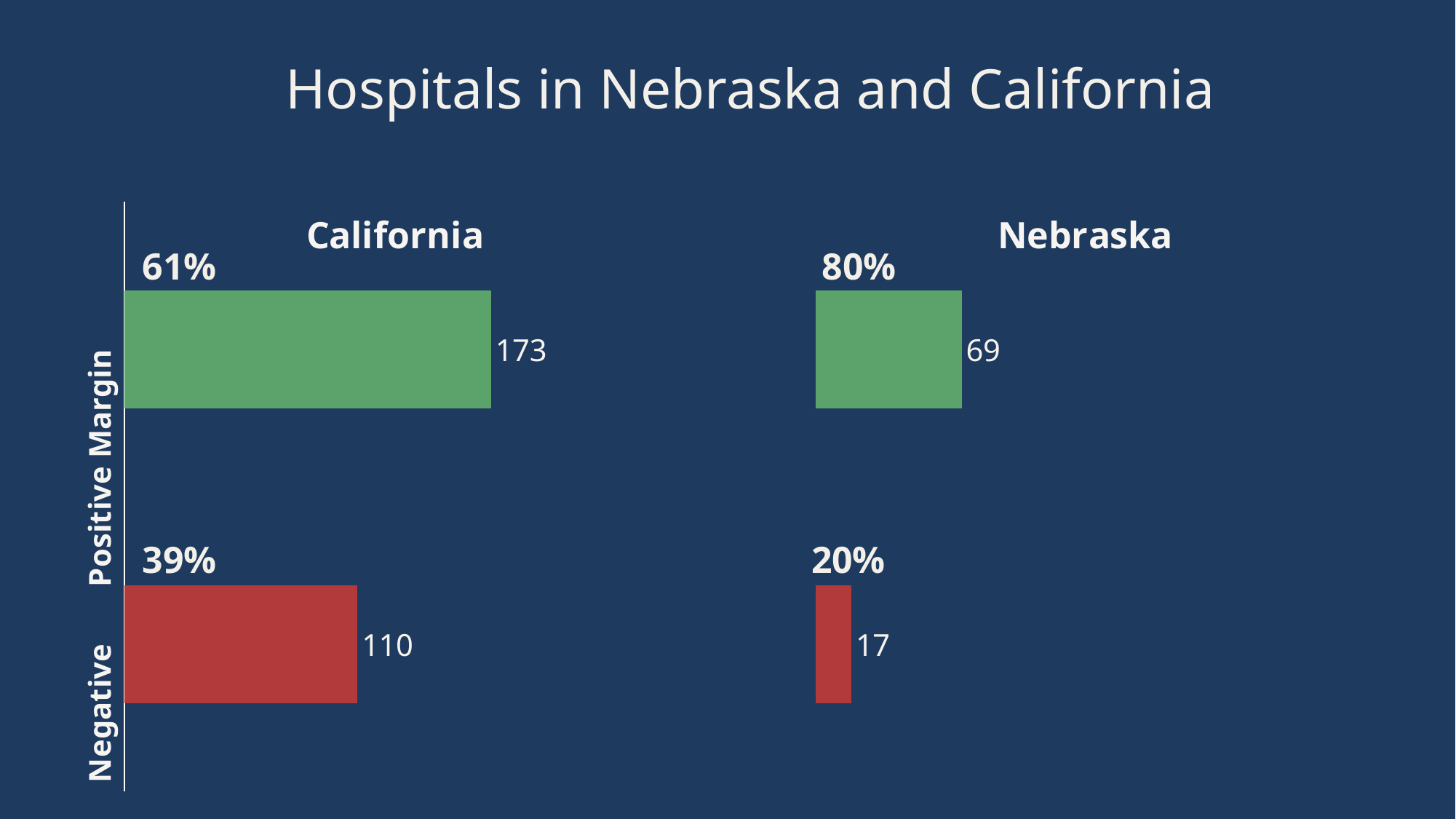
What is the title of the slide? Hospitals in Nebraska and California In the Nebraska chart, what is the difference between the positive-margin count and the negative-margin count? 52 What is the total number of hospitals shown for Nebraska (positive plus negative)? 86 Which is larger: the number of negative-margin hospitals in California or the number of positive-margin hospitals in Nebraska? California negative-margin hospitals In the Nebraska chart, how many hospitals have a negative margin? 17 What kind of chart is used on this slide? Bar chart In the California chart, how many hospitals have a positive margin? 173 In the Nebraska chart, which category has the smaller bar? Negative In the California chart, what is the difference between the number of hospitals with a positive margin and those with a negative margin? 63 In the Nebraska chart, what percentage of hospitals have a positive margin? 80% In the California chart, what percentage of hospitals have a negative margin? 39% In the California chart, which category has the larger bar, Positive Margin or Negative? Positive Margin